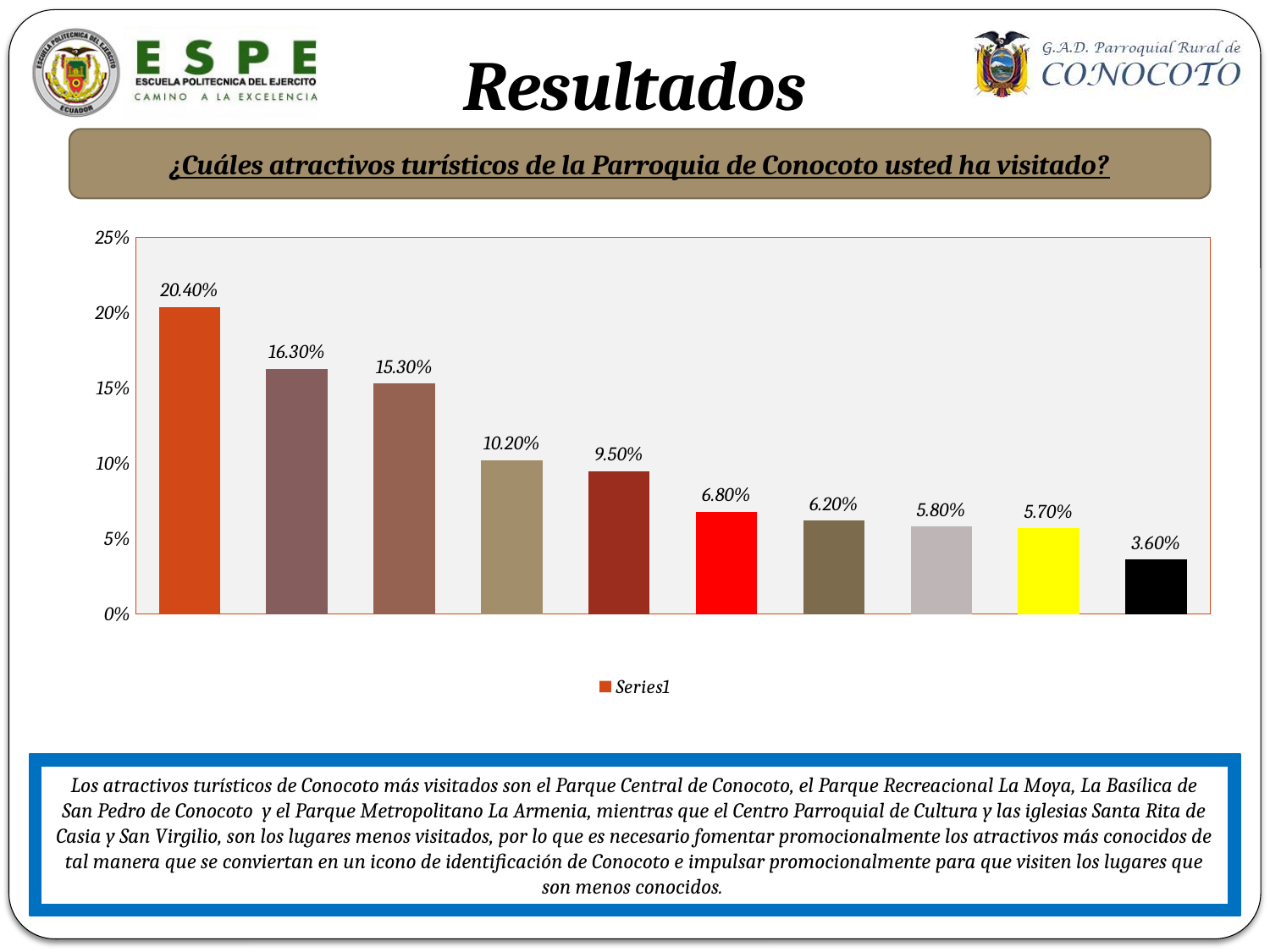
What is the name of the series shown in the legend? Series1 What is the difference between the first bar (20.40%) and the last bar (3.60%)? 16.80% How many bars are plotted in the chart? 10 What is the value of the bright red bar (sixth from the left)? 6.80% What is the value of the yellow bar? 5.70% Do the bar values rise or fall from left to right across the chart? fall How many series does the legend list? 1 What kind of chart is shown on the slide? bar chart What is the value shown on the shortest bar in the chart? 3.60% What is the value shown on the tallest bar in the chart? 20.40% What is the value of the second bar from the left? 16.30% Which is larger, the value of the third bar from the left or the fourth bar from the left? the third bar (15.30%)